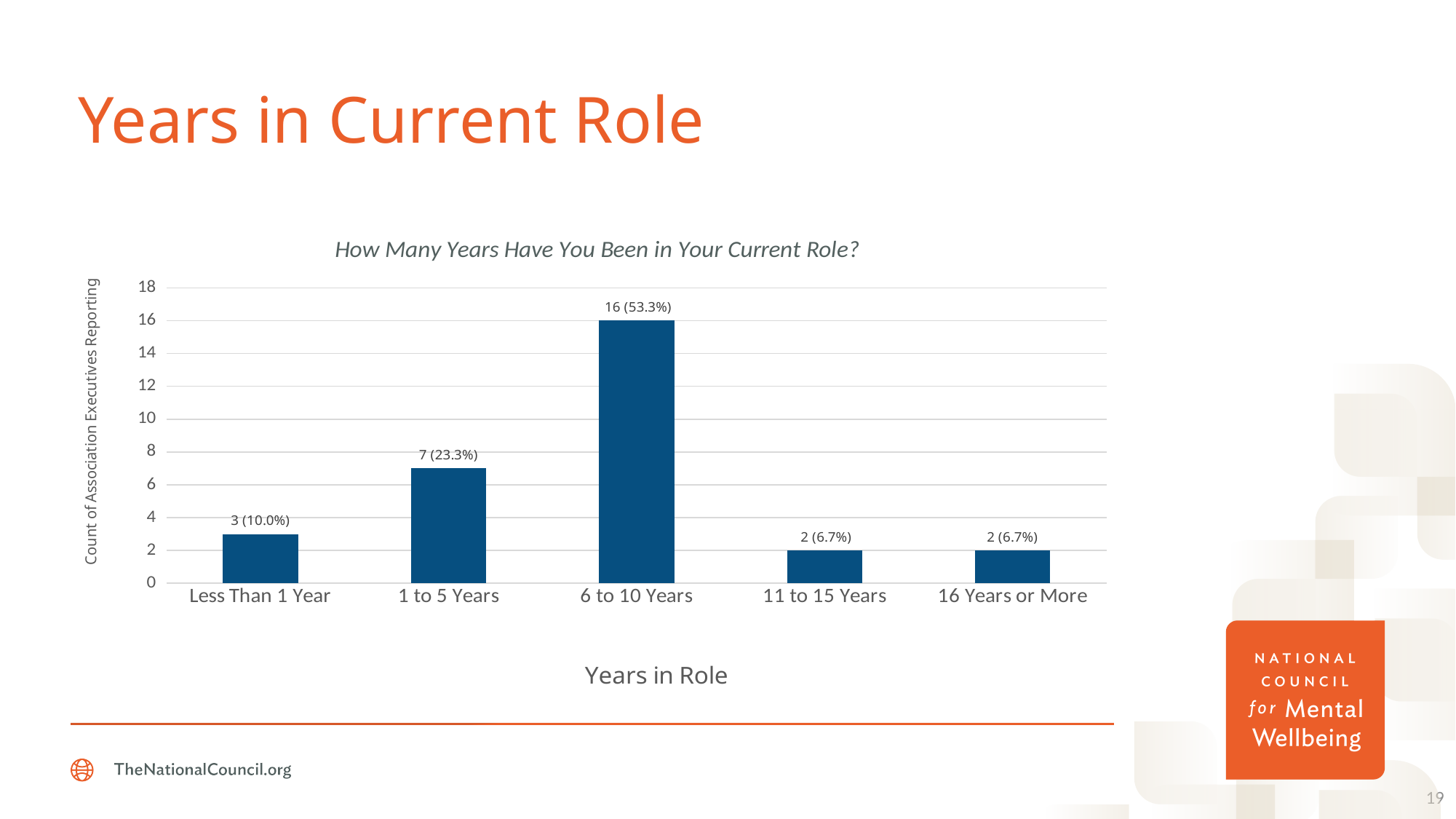
Is the value for 6 to 10 Years greater or less than 14? greater How many categories are shown on the x axis? 5 Which has a larger count, Less Than 1 Year or 1 to 5 Years? 1 to 5 Years What is the count for the 1 to 5 Years category? 7 (23.3%) What kind of chart is shown on the slide? Bar chart What is the count for the Less Than 1 Year category? 3 (10.0%) What is the title of the chart? How Many Years Have You Been in Your Current Role? Which categories share the lowest count? 11 to 15 Years and 16 Years or More What is the difference in count between 6 to 10 Years and 1 to 5 Years? 9 What is the count of association executives reporting 6 to 10 years in their current role? 16 (53.3%) What percentage is shown for the 11 to 15 Years category? 6.7% Which category has the highest count? 6 to 10 Years